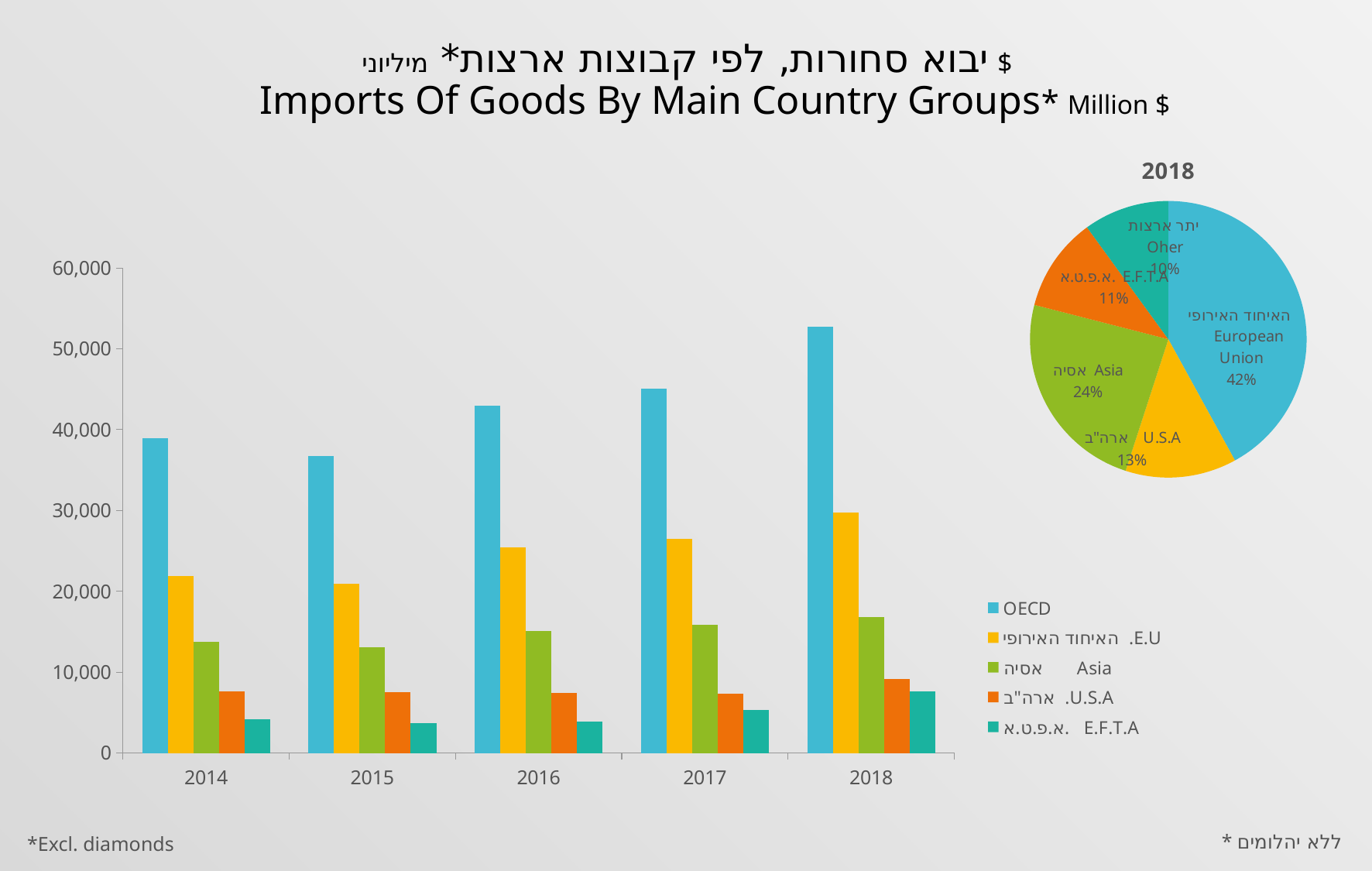
In the bar chart, how many series does the legend list? 5 In the pie chart for 2018, which country group has the largest share? European Union In the bar chart, how many years are shown on the x axis? 5 In the pie chart for 2018, how many percentage points larger is the European Union share than the Asia share? 18 In the bar chart, is the value for OECD in 2015 greater or less than 40,000? less In the pie chart for 2018, what share of imports comes from the U.S.A? 13% In the bar chart, is the value for OECD in 2018 greater or less than 50,000? greater In the pie chart for 2018, which is larger, the E.F.T.A share or the U.S.A share? U.S.A In the bar chart, do the OECD values rise or fall from 2015 to 2018? rise In the pie chart for 2018, what share of imports comes from Asia? 24% In the pie chart for 2018, which slice has the smallest share? Other In the pie chart for 2018, what share of imports comes from the European Union? 42%